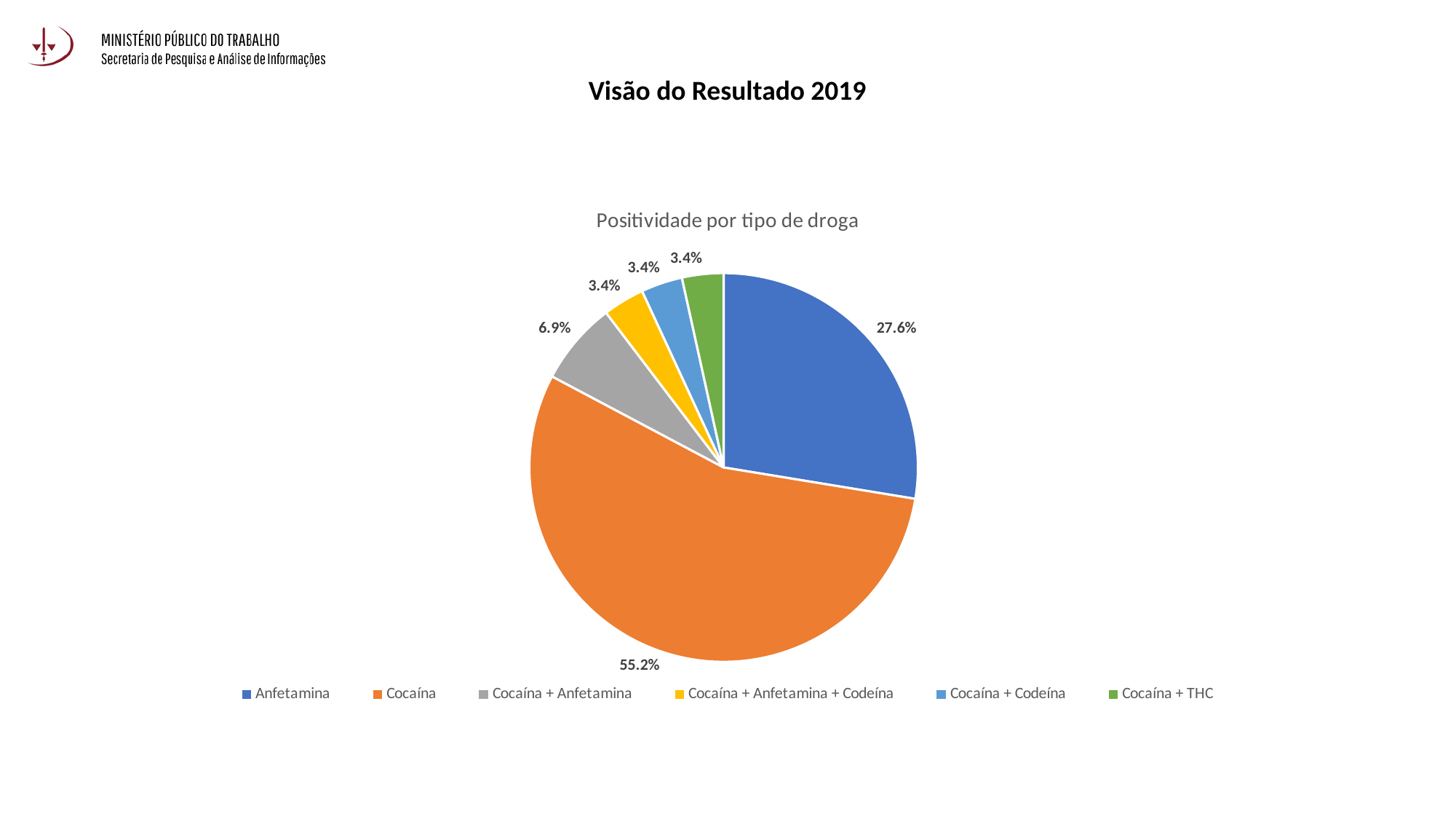
Which category has the largest slice of the pie? Cocaína Which is larger, the slice for Anfetamina or the slice for Cocaína + Anfetamina? Anfetamina What percentage is shown for Cocaína + Anfetamina? 6.9% What is the difference between the Cocaína and Anfetamina percentages? 27.6% How many categories does the legend list? 6 What colour is the Cocaína slice? orange What is the title of the chart? Positividade por tipo de droga What percentage is shown for Cocaína + THC? 3.4% What kind of chart is shown on the slide? pie chart What percentage is shown for Anfetamina? 27.6% What percentage is shown for Cocaína? 55.2% What is the difference between the Cocaína + Anfetamina and Cocaína + Codeína percentages? 3.5%